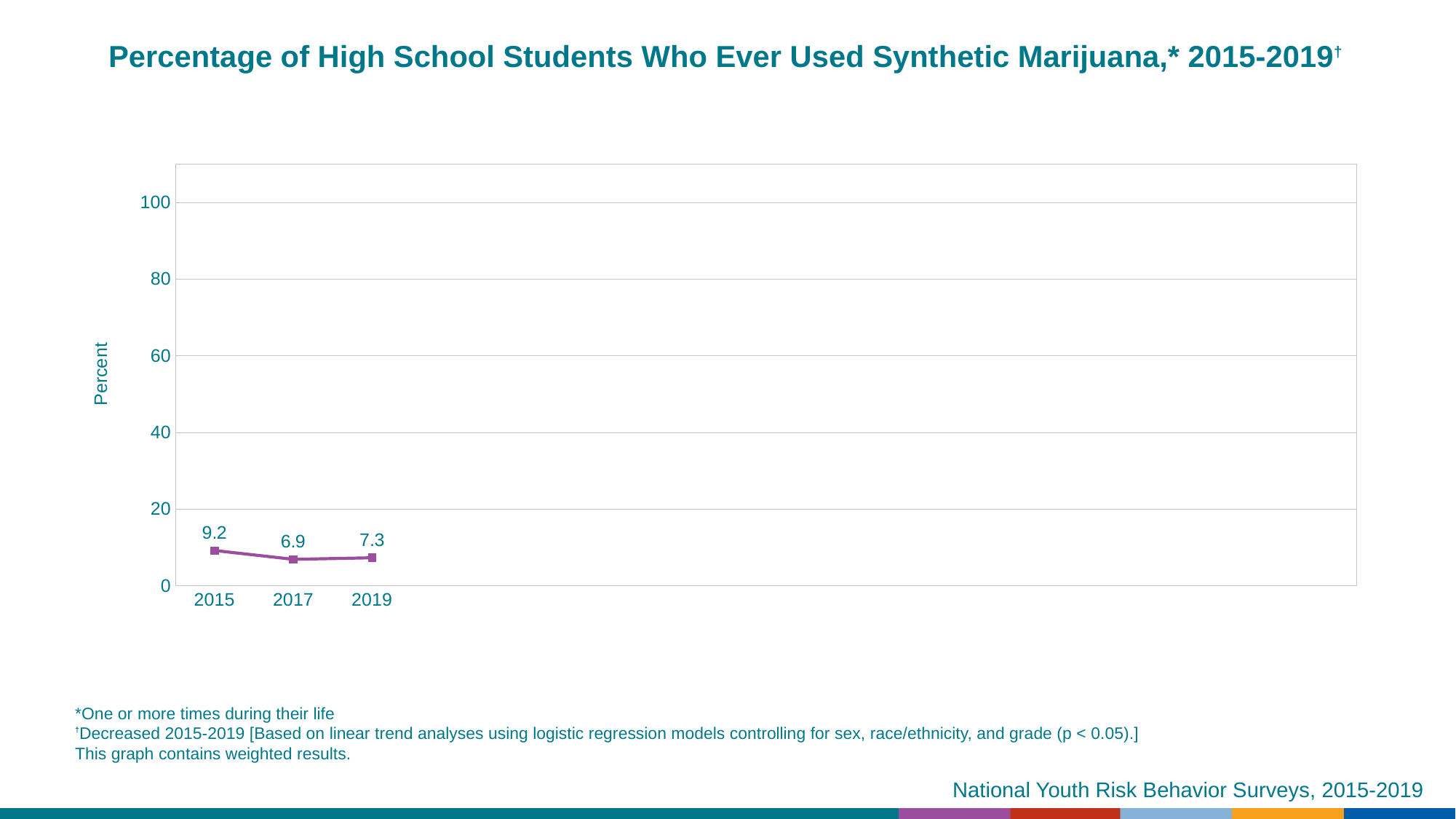
Which year has the lowest percentage of students who ever used synthetic marijuana? 2017 What is the label of the y axis? Percent What kind of chart is shown on the slide? line chart What percentage of high school students had ever used synthetic marijuana in 2017? 6.9 Which year has the highest percentage of students who ever used synthetic marijuana? 2015 What is the difference between the 2015 and 2019 values? 1.9 Which year has a larger value, 2017 or 2019? 2019 How many years are plotted on the chart? 3 What percentage of high school students had ever used synthetic marijuana in 2015? 9.2 What is the difference between the 2015 and 2017 values? 2.3 Is the value for 2015 greater or less than 20? less What percentage of high school students had ever used synthetic marijuana in 2019? 7.3